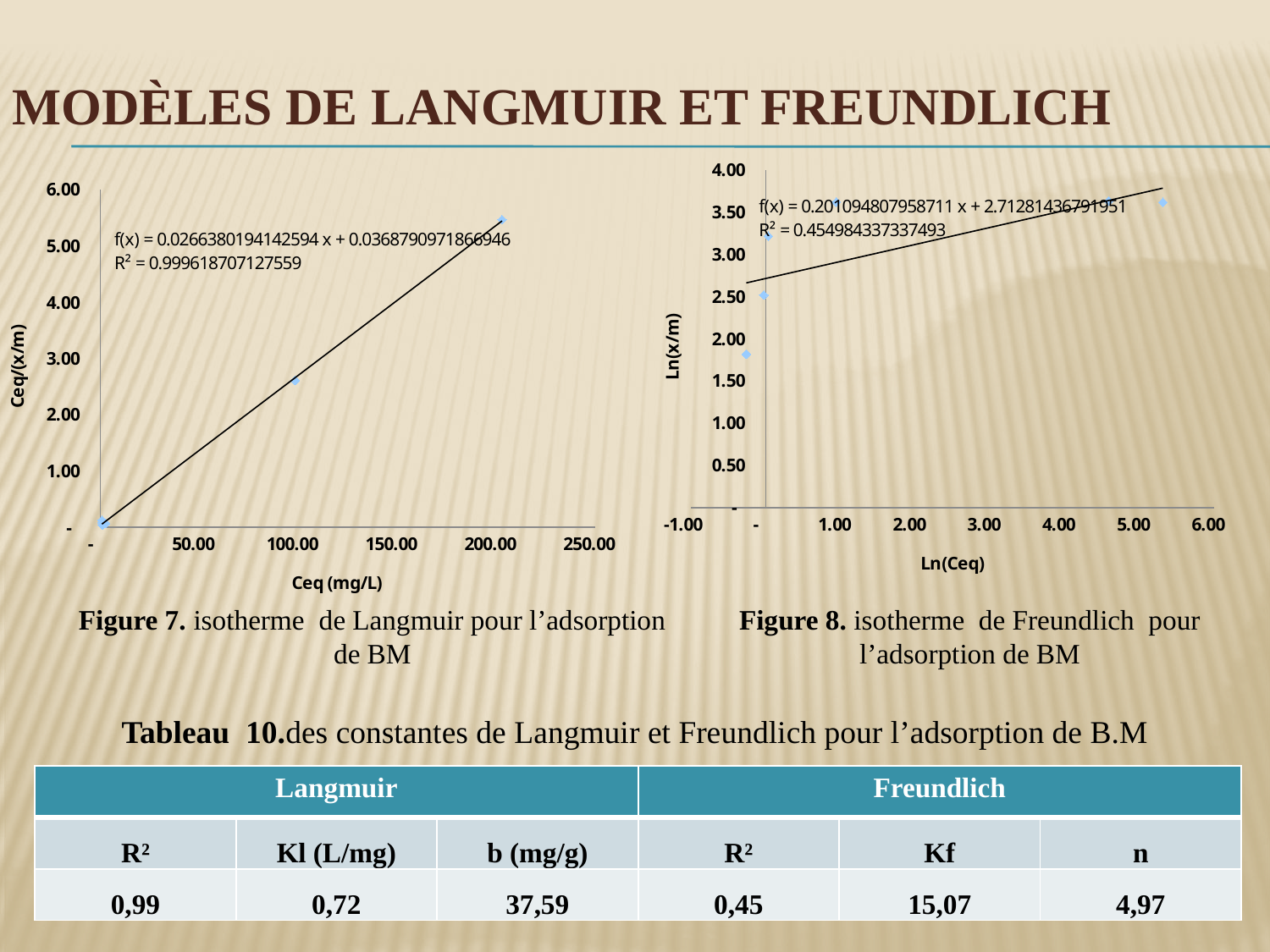
In Figure 8 (the right chart), how many data points are plotted? 6 What kind of chart is Figure 7 (the left chart)? scatter chart In Figure 8 (the right chart), is the lowest plotted point greater or less than 2.00? less In Figure 8 (the right chart), is the value of the rightmost point greater or less than 3.00? greater What is the x-axis title of Figure 7 (the left chart)? Ceq (mg/L) In Figure 7 (the left chart), how many data points are plotted? 6 What kind of chart is Figure 8 (the right chart)? scatter chart In Figure 8 (the right chart), does the fitted trendline rise or fall as Ln(Ceq) increases? rise In Figure 7 (the left chart), is the value of the rightmost point greater or less than 5.00? greater What R² value is printed on Figure 8 (the right chart)? R² = 0.454984337337493 In Figure 7 (the left chart), do the values rise or fall as Ceq (mg/L) increases? rise